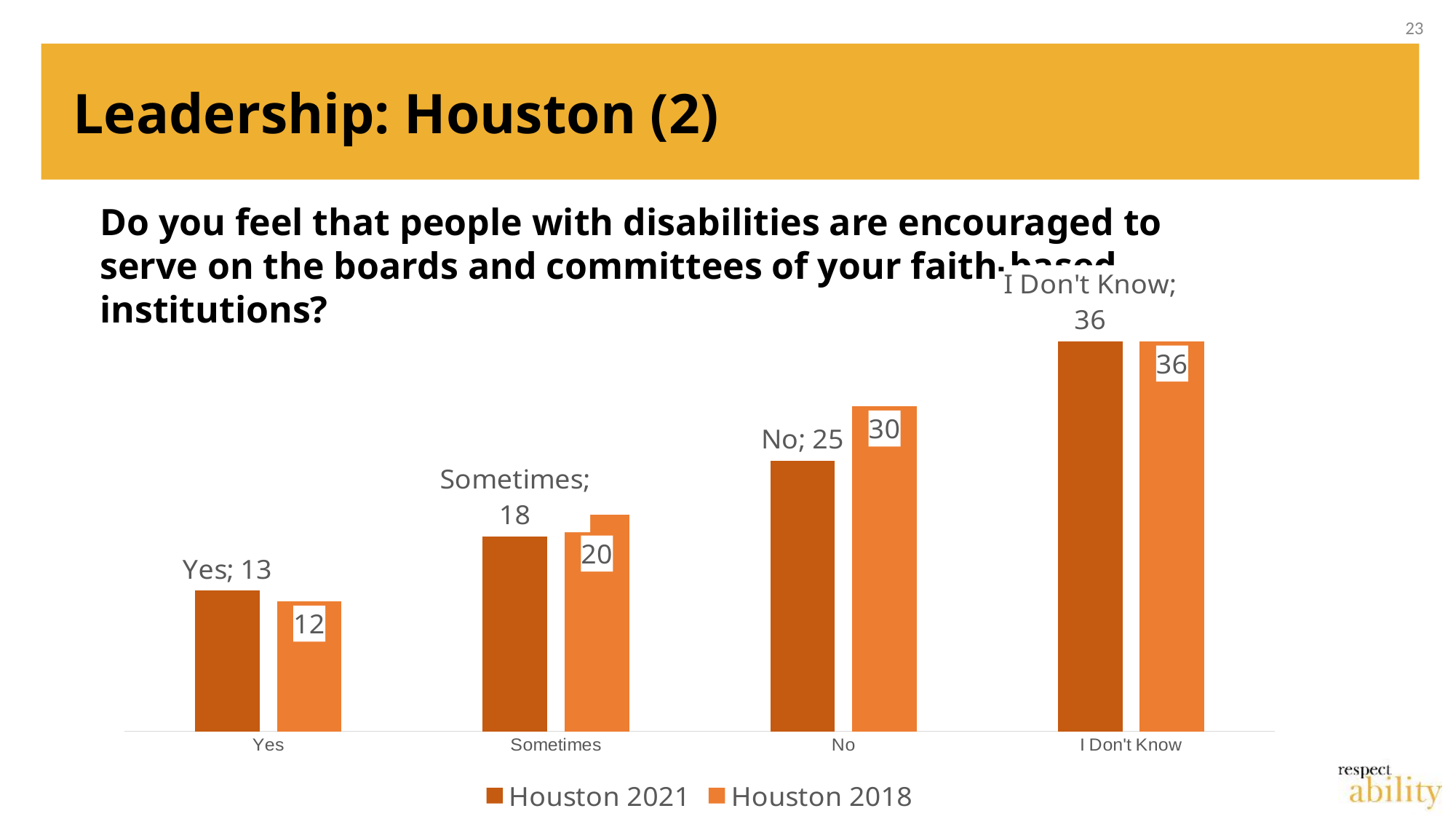
How many series does the legend list? 2 Which category has the lowest Houston 2021 value? Yes Which category has the highest Houston 2018 value? I Don't Know Which is larger for "Yes": the Houston 2021 value or the Houston 2018 value? Houston 2021 What is the Houston 2021 value for "Yes"? 13 What is the Houston 2021 value for "No"? 25 What is the difference between the Houston 2018 and Houston 2021 values for "No"? 5 How many categories are shown on the x axis? 4 What kind of chart is shown on the slide? Bar chart What is the Houston 2018 value for "Sometimes"? 20 Do the Houston 2021 values rise or fall from "Yes" to "I Don't Know"? Rise What are the two series named in the legend? Houston 2021 and Houston 2018